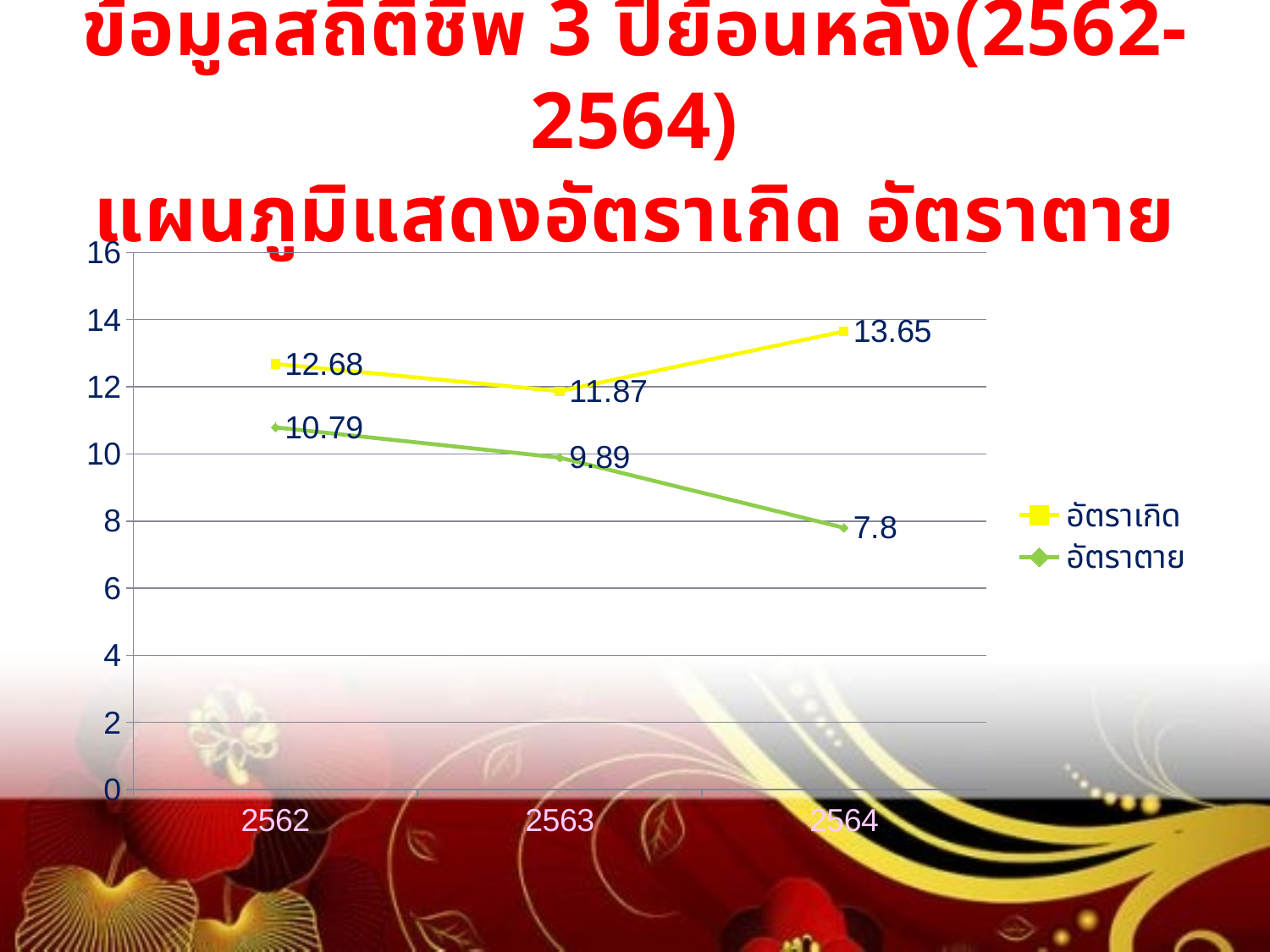
In which year is อัตราเกิด highest? 2564 What is the value of อัตราตาย in 2563? 9.89 Which is larger in 2562, อัตราเกิด or อัตราตาย? อัตราเกิด What is the difference between อัตราเกิด and อัตราตาย in 2564? 5.85 How many years are shown on the x axis? 3 What kind of chart is shown on the slide? line chart How many series does the legend list? 2 Does อัตราตาย rise or fall from 2562 to 2564? fall In which year is อัตราตาย lowest? 2564 What is the value of อัตราตาย in 2564? 7.8 What is the value of อัตราเกิด in 2563? 11.87 What is the value of อัตราเกิด in 2562? 12.68